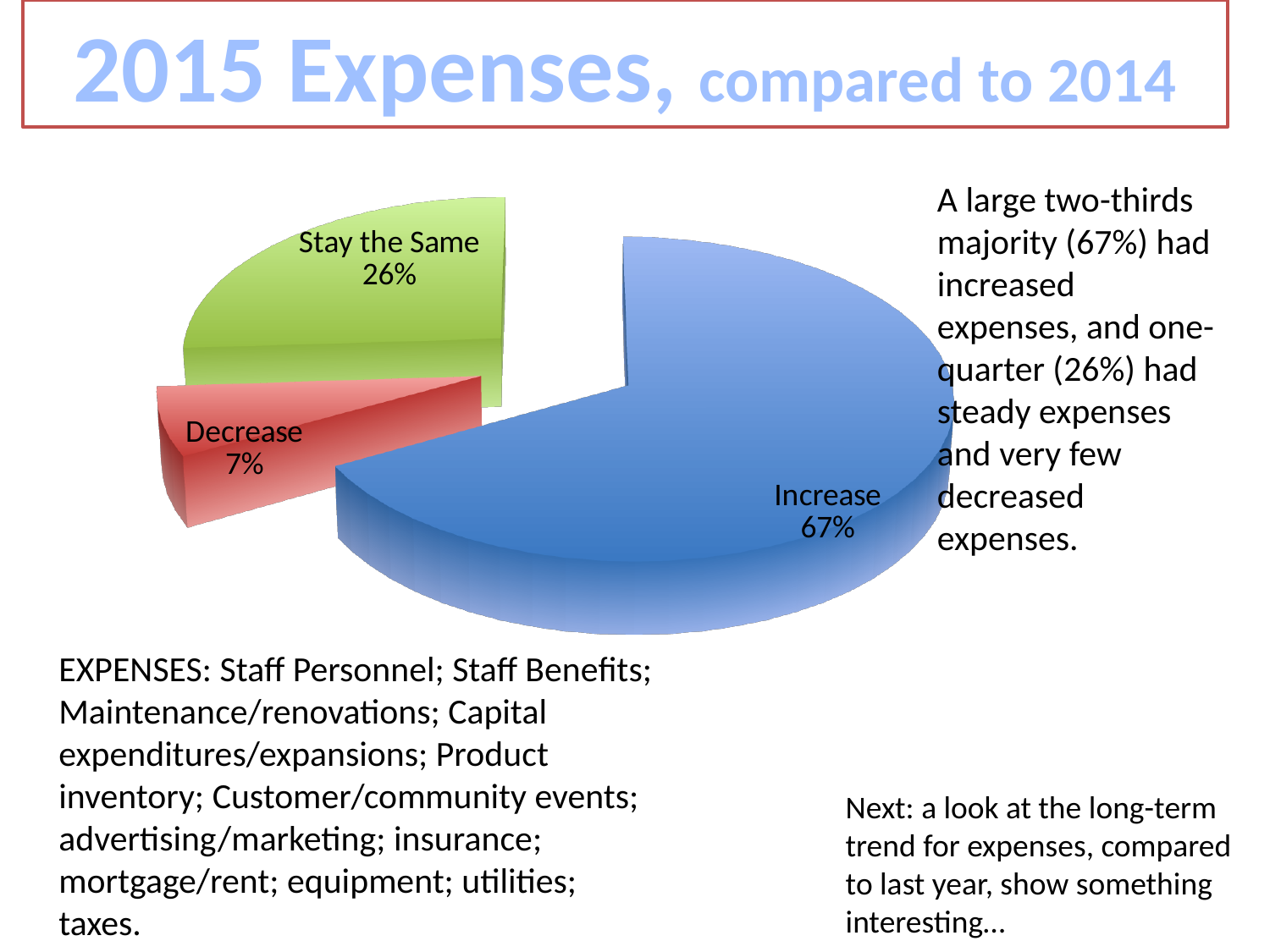
What percentage of the pie chart is labelled Stay the Same? 26% What percentage of the pie chart is labelled Increase? 67% What colour is the Increase slice of the pie chart? Blue What is the difference in percentage points between the Increase and Stay the Same slices? 41 What colour is the Decrease slice of the pie chart? Red Which is larger, the Stay the Same slice or the Decrease slice? Stay the Same Which slice of the pie chart is the smallest? Decrease What is the difference in percentage points between the Stay the Same and Decrease slices? 19 What kind of chart is shown on the slide? Pie chart How many slices does the pie chart have? 3 Which slice of the pie chart is the largest? Increase What percentage of the pie chart is labelled Decrease? 7%